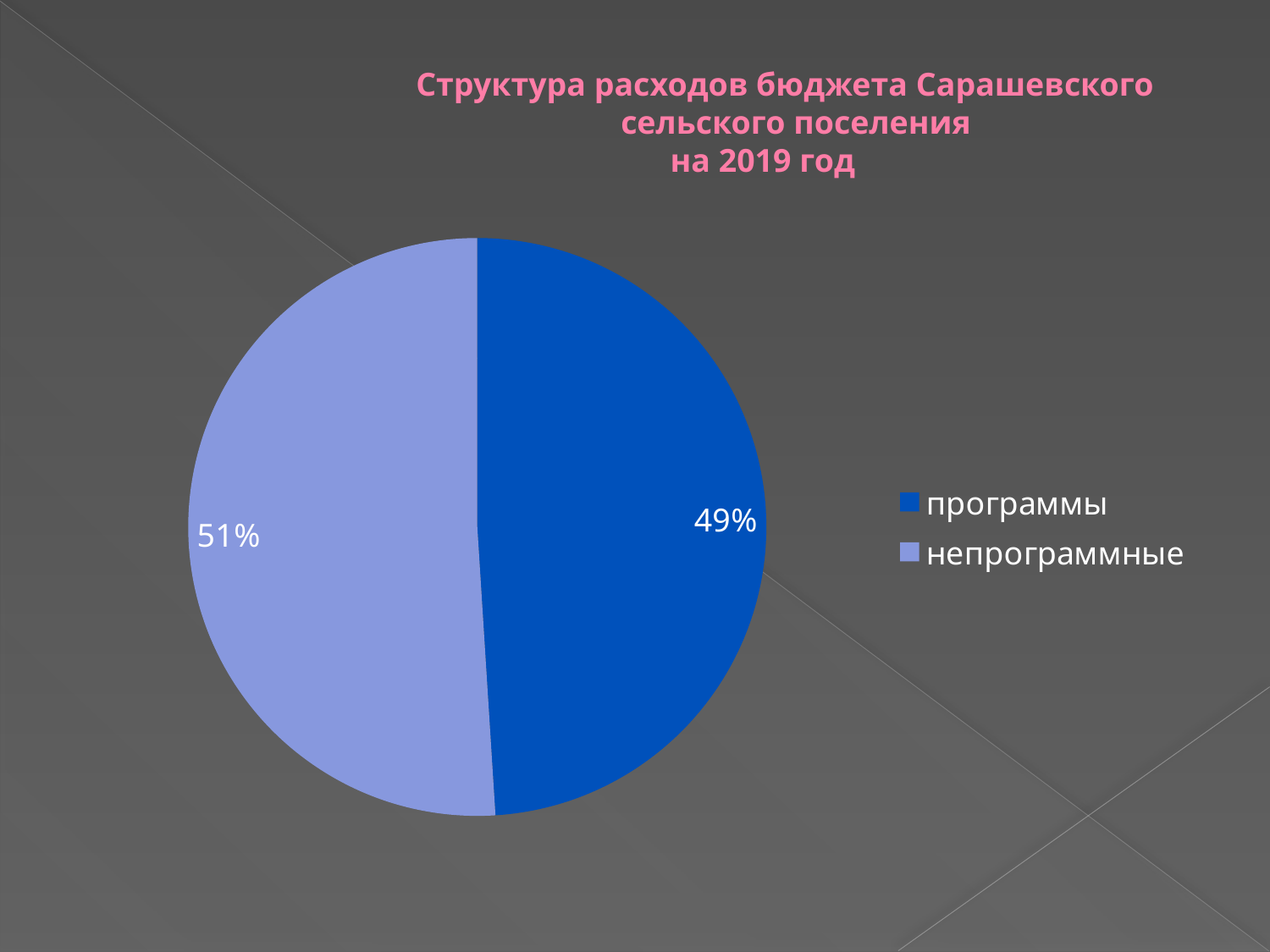
What kind of chart is shown on the slide? pie chart Which slice is the largest? непрограммные Which slice is the smallest? программы What share of the pie does the 'непрограммные' slice represent? 51% What share of the pie does the 'программы' slice represent? 49% What is the title of the chart? Структура расходов бюджета Сарашевского сельского поселения на 2019 год How many slices does the pie chart have? 2 How many entries does the legend list? 2 Which is larger, the 'программы' slice or the 'непрограммные' slice? непрограммные What is the difference in percentage points between the 'непрограммные' and 'программы' slices? 2% Which legend entry is shown in dark blue? программы